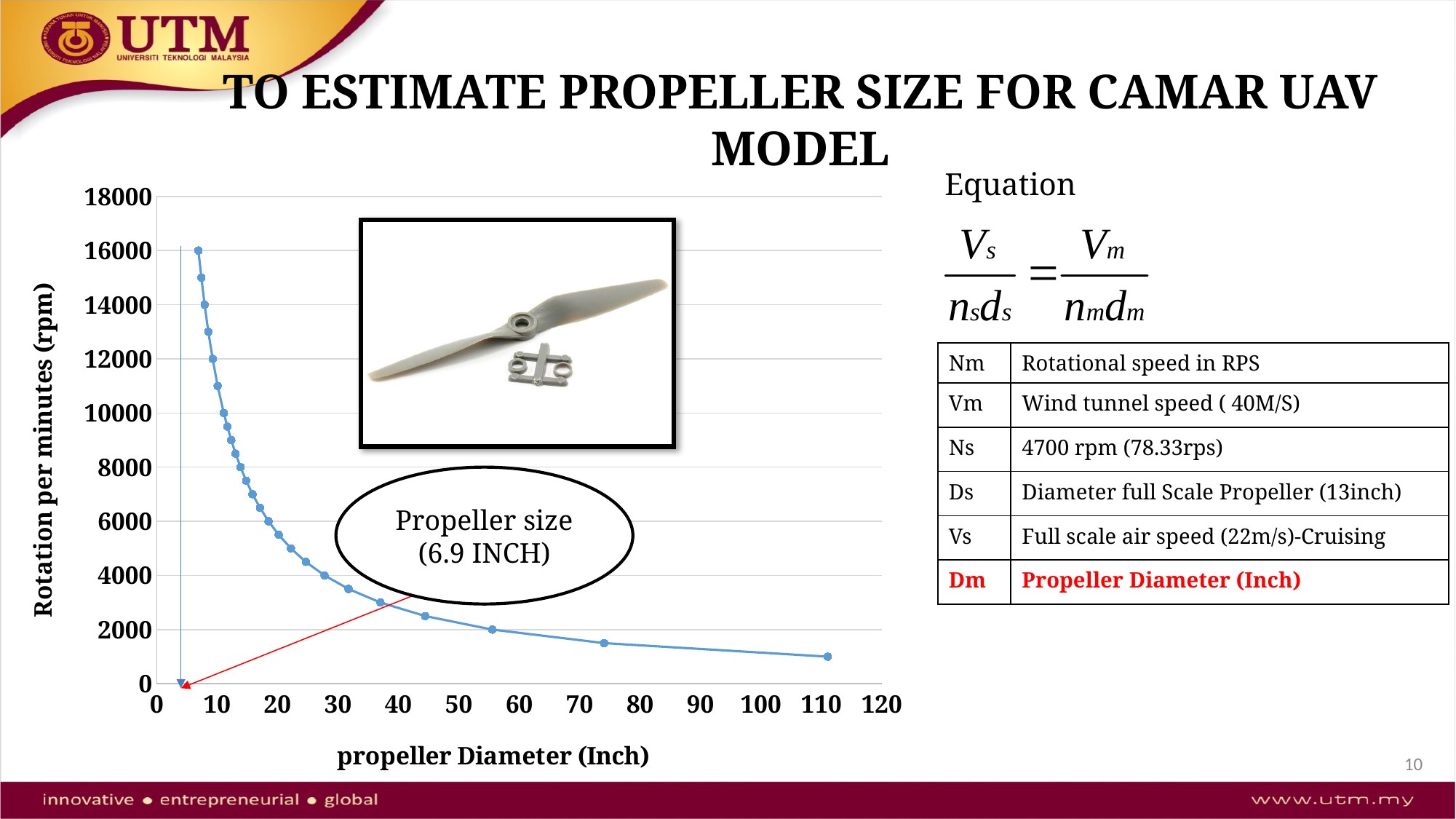
Is the rotation per minute value for the point at the smallest propeller diameter greater or less than 14000? greater Which point has the highest rotation per minute value: the one at the smallest diameter or the one at the largest diameter? The one at the smallest diameter Is the rotation per minute value for the point at the largest propeller diameter (about 111 inch) greater or less than 2000? less What is the label of the y axis of the chart? Rotation per minutes (rpm) Do the rotation per minute values rise or fall as propeller diameter increases along the x axis? Fall Is the rotation per minute value for the point at about 37 inch diameter greater or less than 4000? less What is the label of the x axis of the chart? propeller Diameter (Inch) What is the highest value shown on the y axis of the chart? 18000 What kind of chart is shown on the slide? Line chart